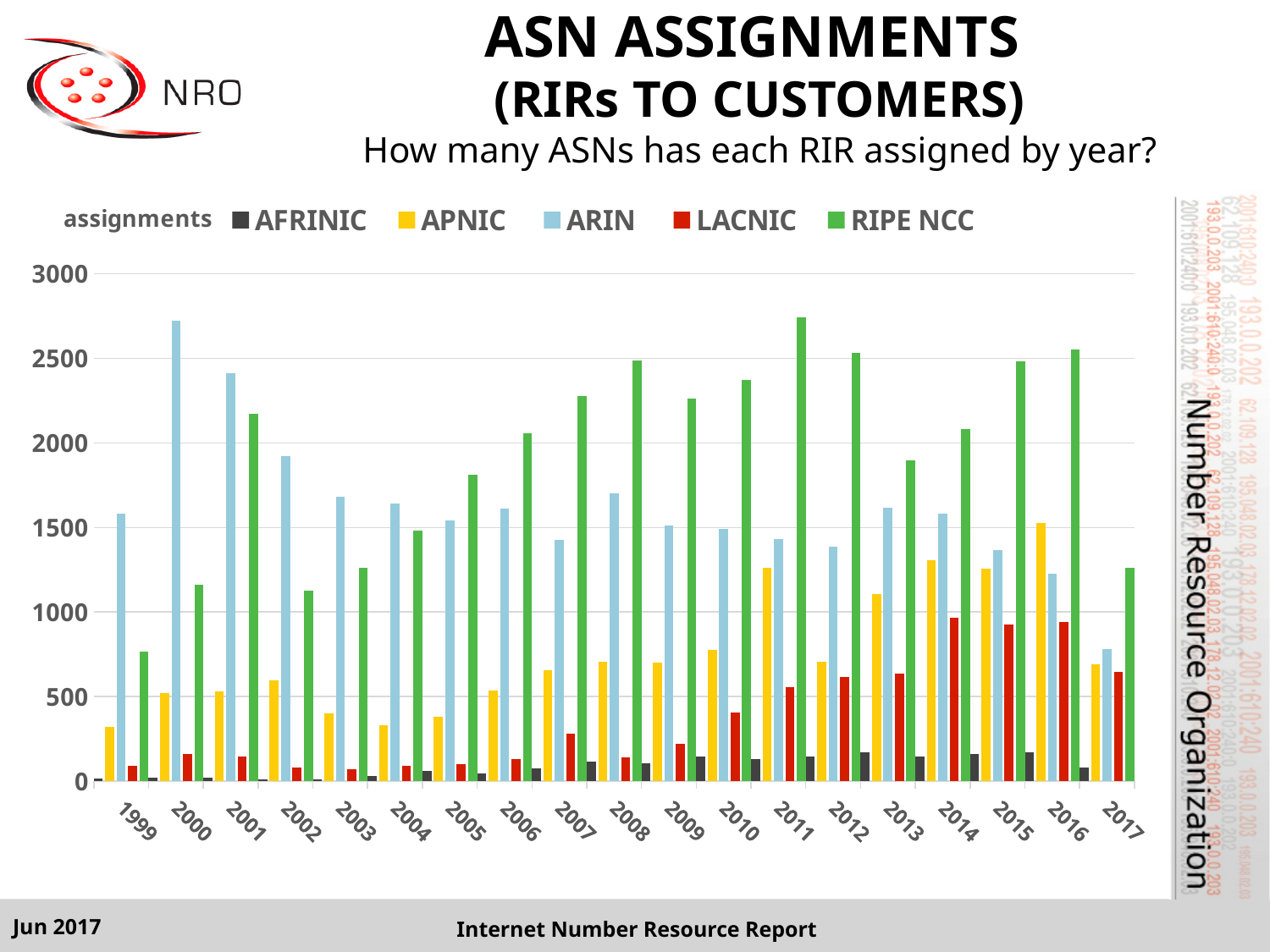
How many years are shown along the x axis? 19 Is the value for ARIN in 2017 greater or less than 1000? less How many series does the legend list? 5 In which year is the ARIN bar the lowest? 2017 Is the value for APNIC in 2016 greater or less than 1000? greater In which year is the ARIN bar the highest? 2000 Which is larger in 1999, the ARIN value or the RIPE NCC value? ARIN Which is larger in 2017, the ARIN value or the RIPE NCC value? RIPE NCC Is the value for ARIN in 2000 greater or less than 2500? greater What kind of chart is shown on the slide? bar chart In which year is the RIPE NCC bar the highest? 2011 Which series is shown in green? RIPE NCC